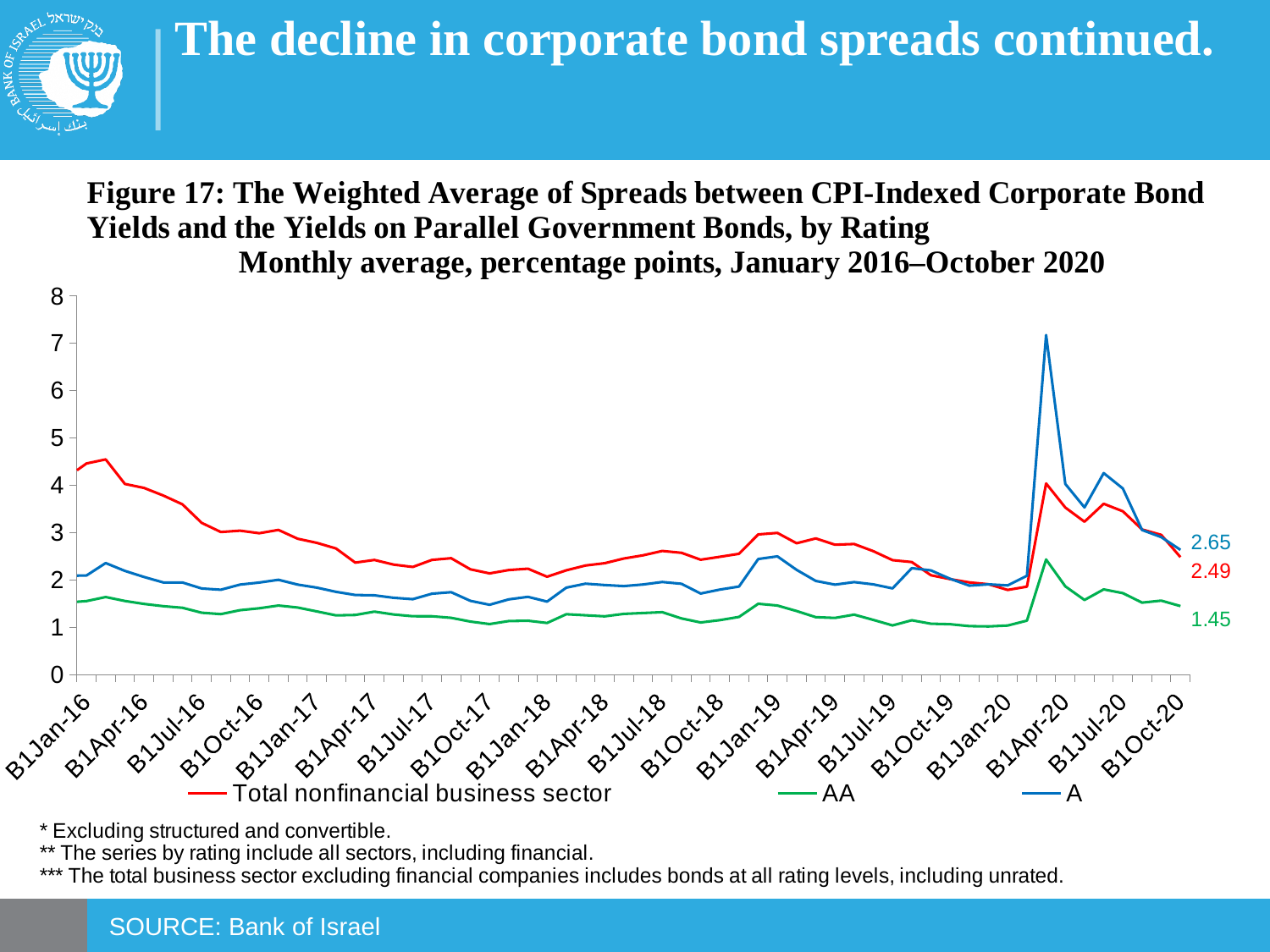
What is the difference between the final labelled values of the A series and the AA series? 1.20 What type of chart is shown on the slide? line chart How many series does the legend list? 3 Which series has the lowest labelled value at the end of the chart? AA Which series has the highest labelled value at the end of the chart? A Is the peak value of the A series around April 2020 greater or less than 6? greater What is the final labelled value for the A series at the end of the chart? 2.65 What is the final labelled value for the AA series? 1.45 What is the difference between the final labelled values of the A series and the Total nonfinancial business sector series? 0.16 Is the value of the Total nonfinancial business sector series at January 2016 greater or less than 4? greater What is the final labelled value for the Total nonfinancial business sector series? 2.49 Does the Total nonfinancial business sector series rise or fall between January 2016 and April 2017? fall